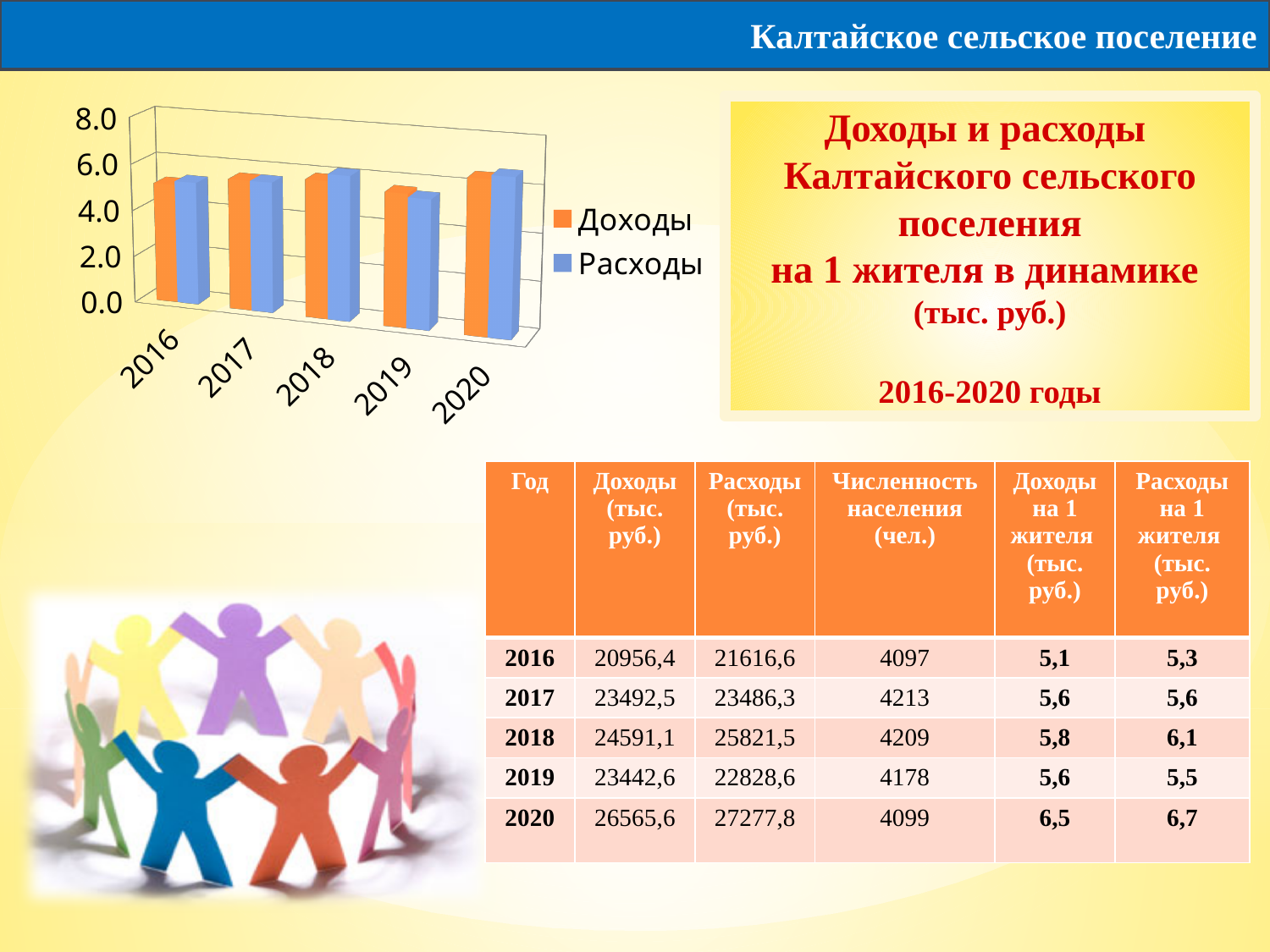
How many series does the chart legend list? 2 Is the Расходы value for 2019 greater or less than 6.0? less What are the two legend entries of the chart? Доходы, Расходы Which series in the chart is drawn in orange? Доходы What kind of chart is shown on the slide? bar chart How many years are shown on the x axis of the chart? 5 In which year is the Расходы bar the highest? 2020 In which year is the Доходы bar the lowest? 2016 In which year is the Доходы bar the highest? 2020 Is the Доходы value for 2016 greater or less than 4.0? greater In 2018, which is larger in the chart, Доходы or Расходы? Расходы Is the Расходы value for 2020 greater or less than 6.0? greater